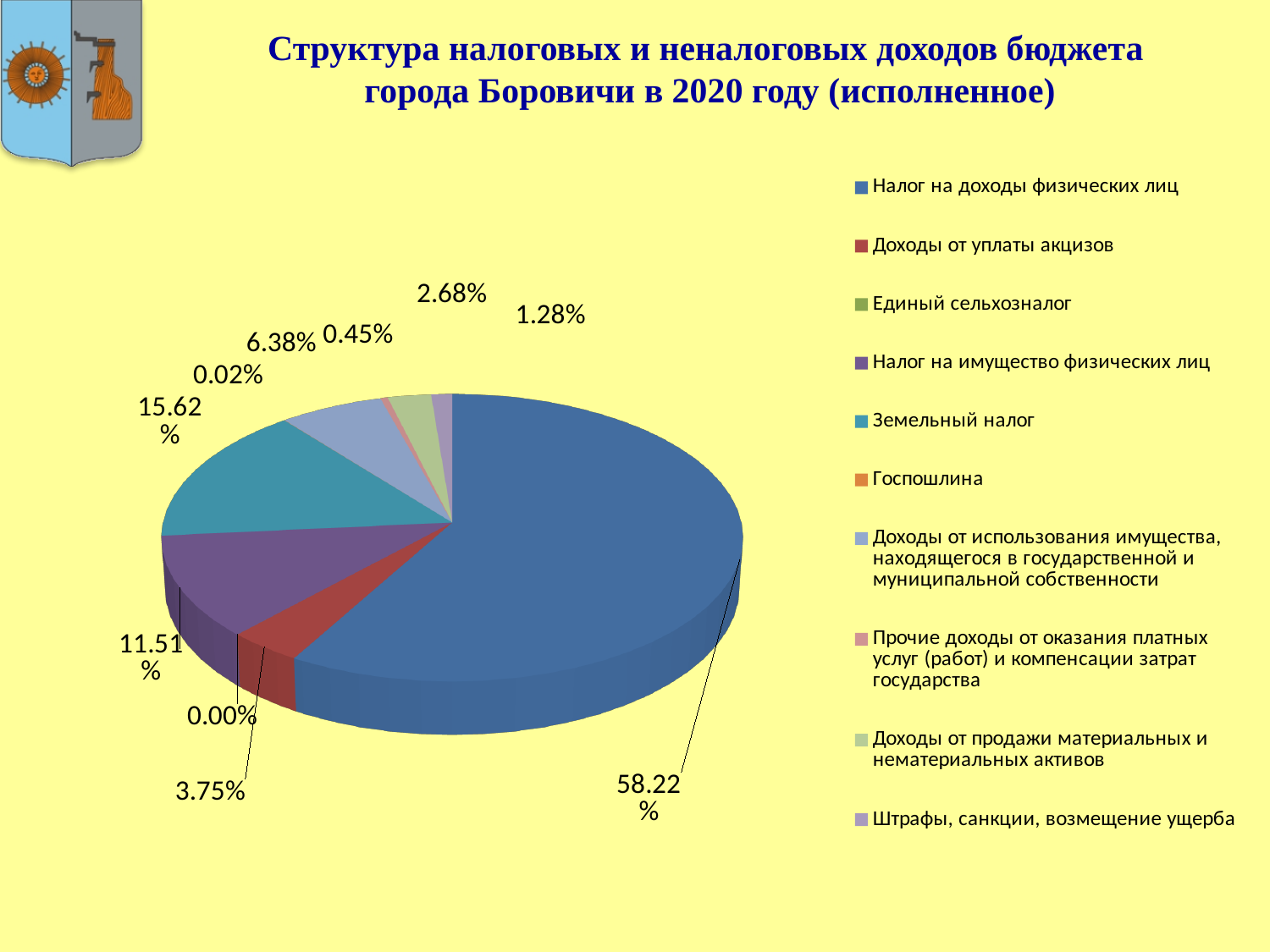
How many series does the legend list? 10 What is the title of the chart on the slide? Структура налоговых и неналоговых доходов бюджета города Боровичи в 2020 году (исполненное) Which is larger, the share for Земельный налог or the share for Налог на имущество физических лиц? Земельный налог What is the value shown for Земельный налог? 15.62% What is the value shown for Доходы от уплаты акцизов? 3.75% Which category has the largest share of the pie? Налог на доходы физических лиц What is the value shown for Доходы от использования имущества, находящегося в государственной и муниципальной собственности? 6.38% What is the difference between the share for Земельный налог and the share for Налог на имущество физических лиц? 4.11% What kind of chart is shown on the slide? pie chart What share of the pie is labelled for Налог на доходы физических лиц? 58.22% What is the value shown for Налог на имущество физических лиц? 11.51% What is the value shown for Штрафы, санкции, возмещение ущерба? 1.28%